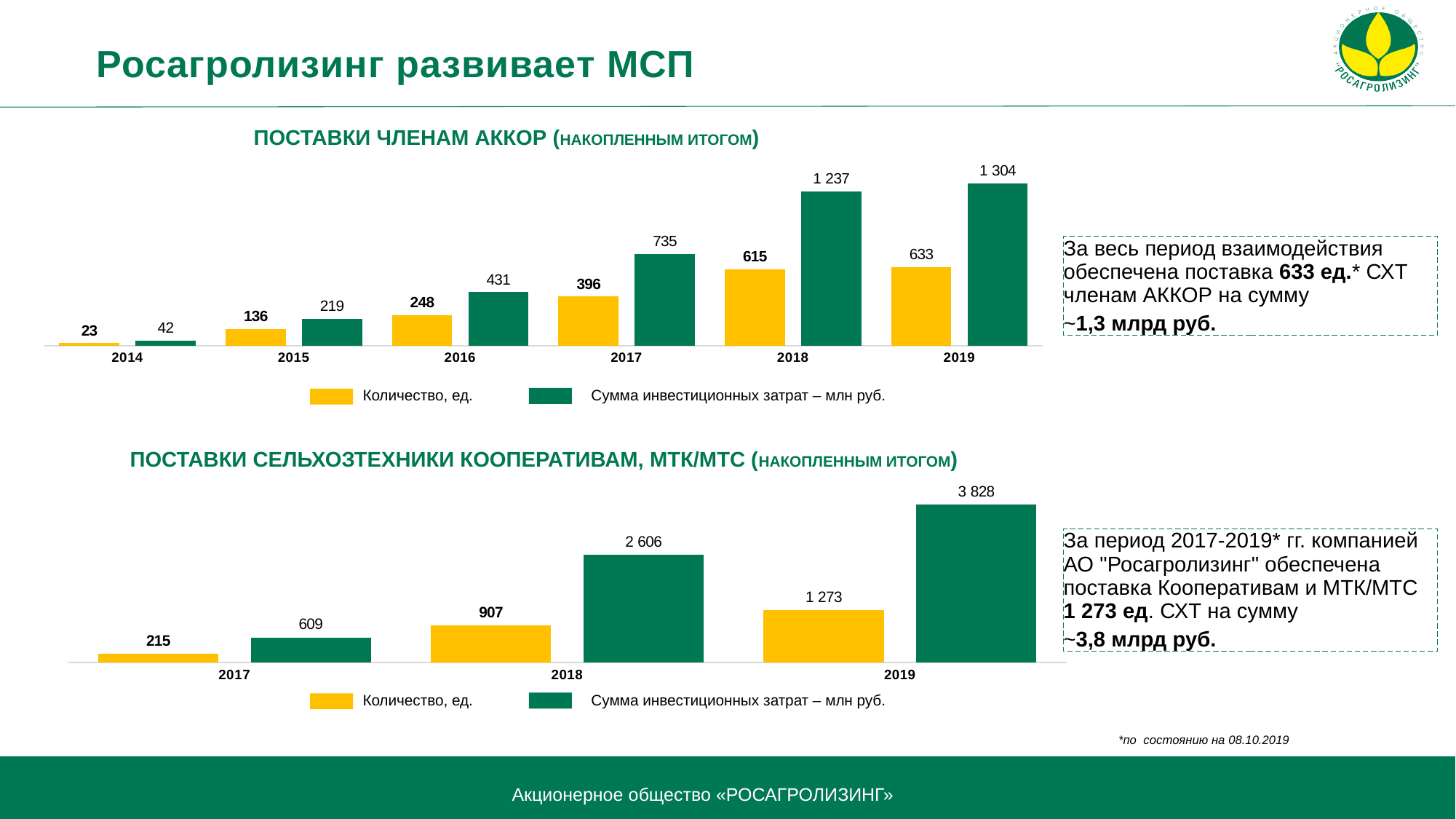
In the bottom chart (ПОСТАВКИ СЕЛЬХОЗТЕХНИКИ КООПЕРАТИВАМ, МТК/МТС), how many series does the legend list? 2 In the top chart (ПОСТАВКИ ЧЛЕНАМ АККОР), which year has the lowest value of Сумма инвестиционных затрат – млн руб.? 2014 In the bottom chart (ПОСТАВКИ СЕЛЬХОЗТЕХНИКИ КООПЕРАТИВАМ, МТК/МТС), what is the value of Количество, ед. for 2018? 907 In the top chart (ПОСТАВКИ ЧЛЕНАМ АККОР), what is the value of Сумма инвестиционных затрат – млн руб. for 2018? 1 237 In the bottom chart (ПОСТАВКИ СЕЛЬХОЗТЕХНИКИ КООПЕРАТИВАМ, МТК/МТС), what is the value of Сумма инвестиционных затрат – млн руб. for 2019? 3 828 What kind of chart is the bottom chart (ПОСТАВКИ СЕЛЬХОЗТЕХНИКИ КООПЕРАТИВАМ, МТК/МТС)? bar chart In the bottom chart (ПОСТАВКИ СЕЛЬХОЗТЕХНИКИ КООПЕРАТИВАМ, МТК/МТС), which year has the highest value of Количество, ед.? 2019 In the top chart (ПОСТАВКИ ЧЛЕНАМ АККОР), how many years are shown on the x axis? 6 In the top chart (ПОСТАВКИ ЧЛЕНАМ АККОР), do the values of Сумма инвестиционных затрат – млн руб. rise or fall from 2014 to 2019? rise In the top chart (ПОСТАВКИ ЧЛЕНАМ АККОР), what is the difference between the Количество, ед. values for 2019 and 2018? 18 In the bottom chart (ПОСТАВКИ СЕЛЬХОЗТЕХНИКИ КООПЕРАТИВАМ, МТК/МТС), what is the difference between the Сумма инвестиционных затрат – млн руб. values for 2018 and 2017? 1 997 In the top chart (ПОСТАВКИ ЧЛЕНАМ АККОР), what is the value of Количество, ед. for 2017? 396